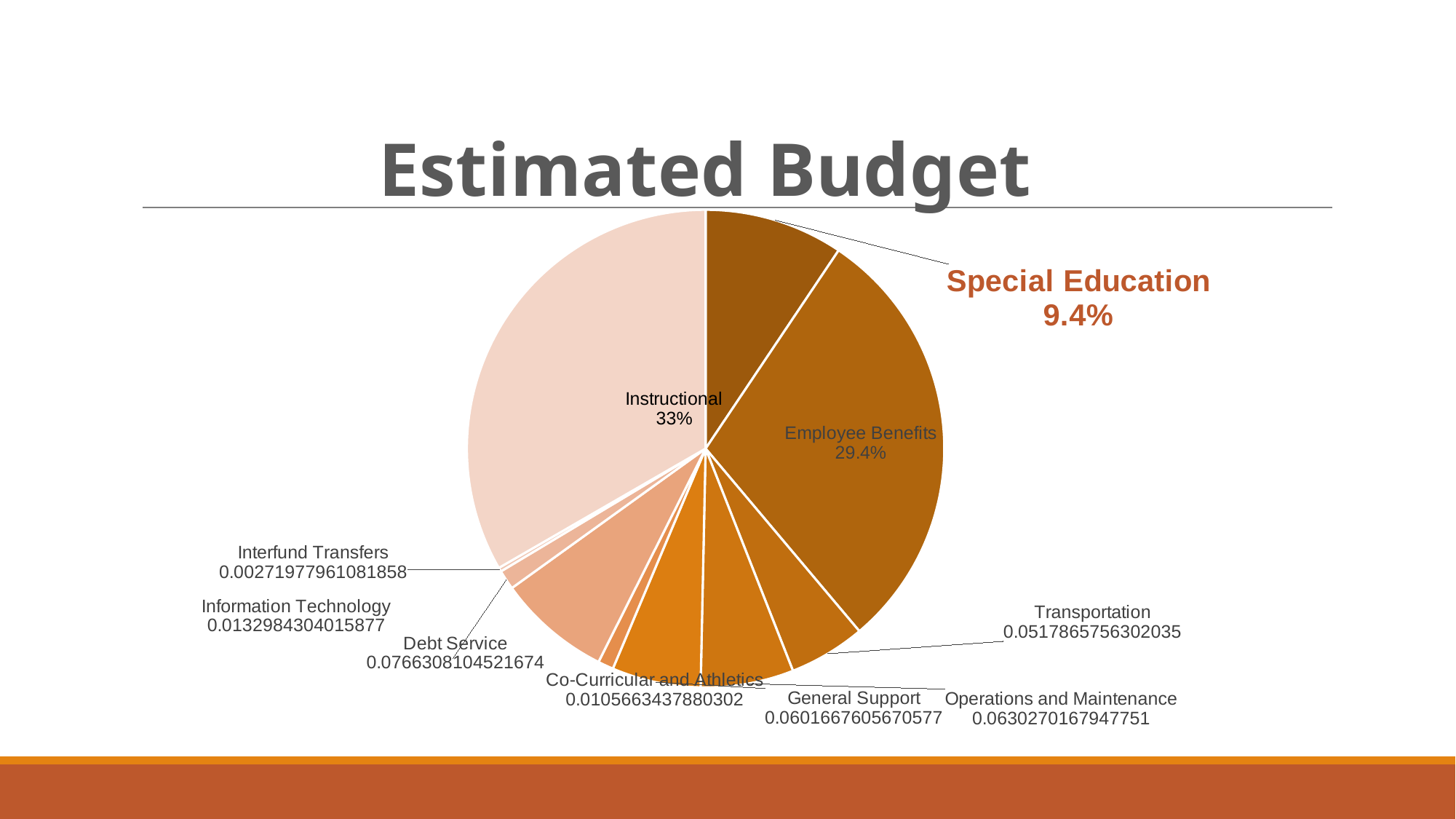
What kind of chart is shown on the slide? pie chart What value is shown for Debt Service? 0.0766308104521674 What share of the budget is Employee Benefits? 29.4% Which category has the largest slice of the pie? Instructional Which category has the smallest slice of the pie? Interfund Transfers How many slices does the pie chart have? 10 What value is shown for Transportation? 0.0517865756302035 What is the title of the chart? Estimated Budget What share of the budget is Special Education? 9.4% What value is shown for Interfund Transfers? 0.00271977961081858 Which is larger, Operations and Maintenance or General Support? Operations and Maintenance What share of the budget is Instructional? 33%